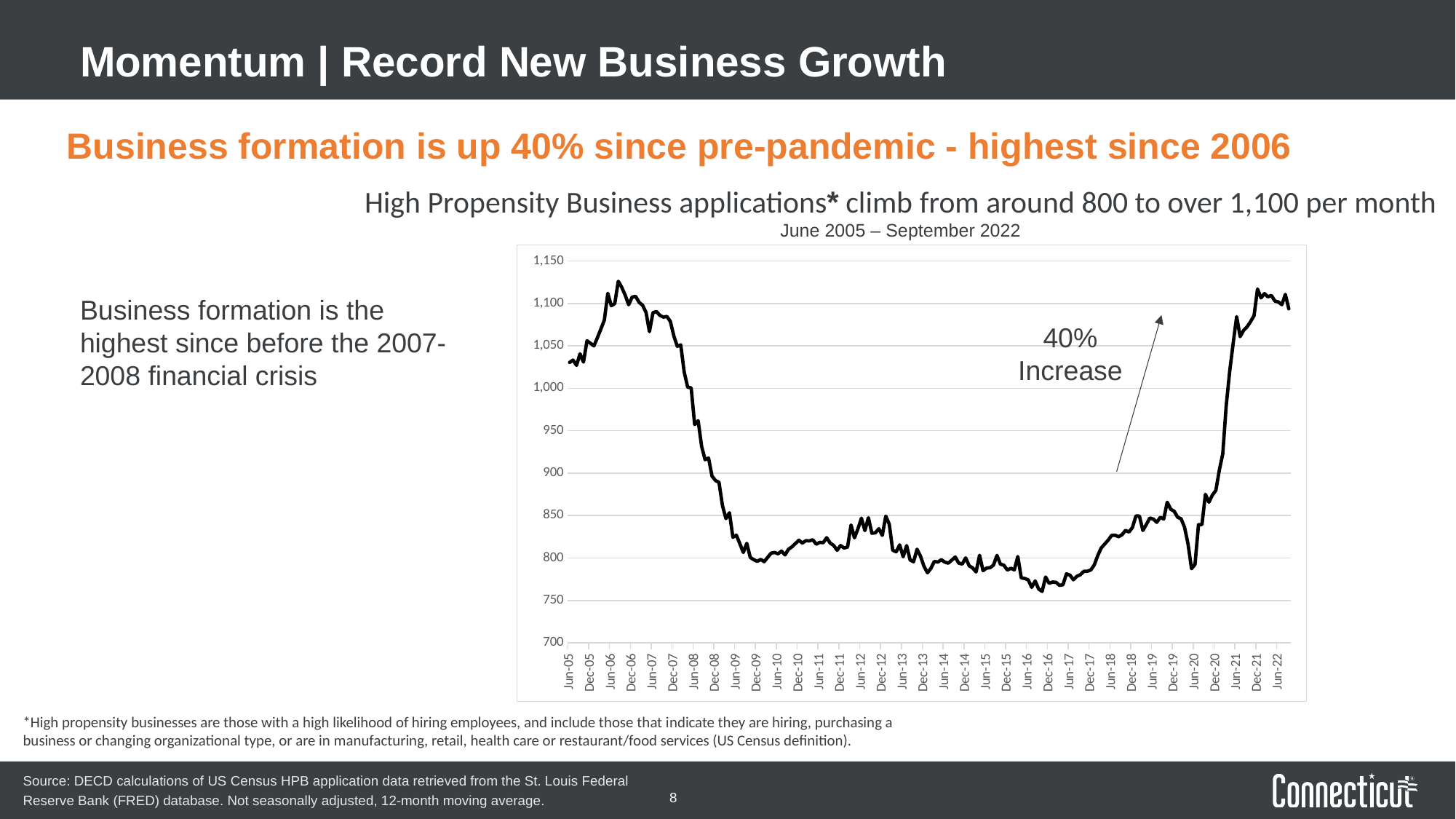
Is the value at Dec-21 greater or less than 1,050? greater Is the value at Jun-19 greater or less than 800? greater Is the value at Jun-16 greater or less than 800? less What date range does the chart's subtitle give? June 2005 – September 2022 In which year does the line reach its lowest point? 2016 What is the title of the chart? High Propensity Business applications* climb from around 800 to over 1,100 per month Does the line rise or fall between Jun-20 and Jun-21? rise What kind of chart is shown on the slide? line chart Does the line rise or fall between Jun-07 and Jun-09? fall